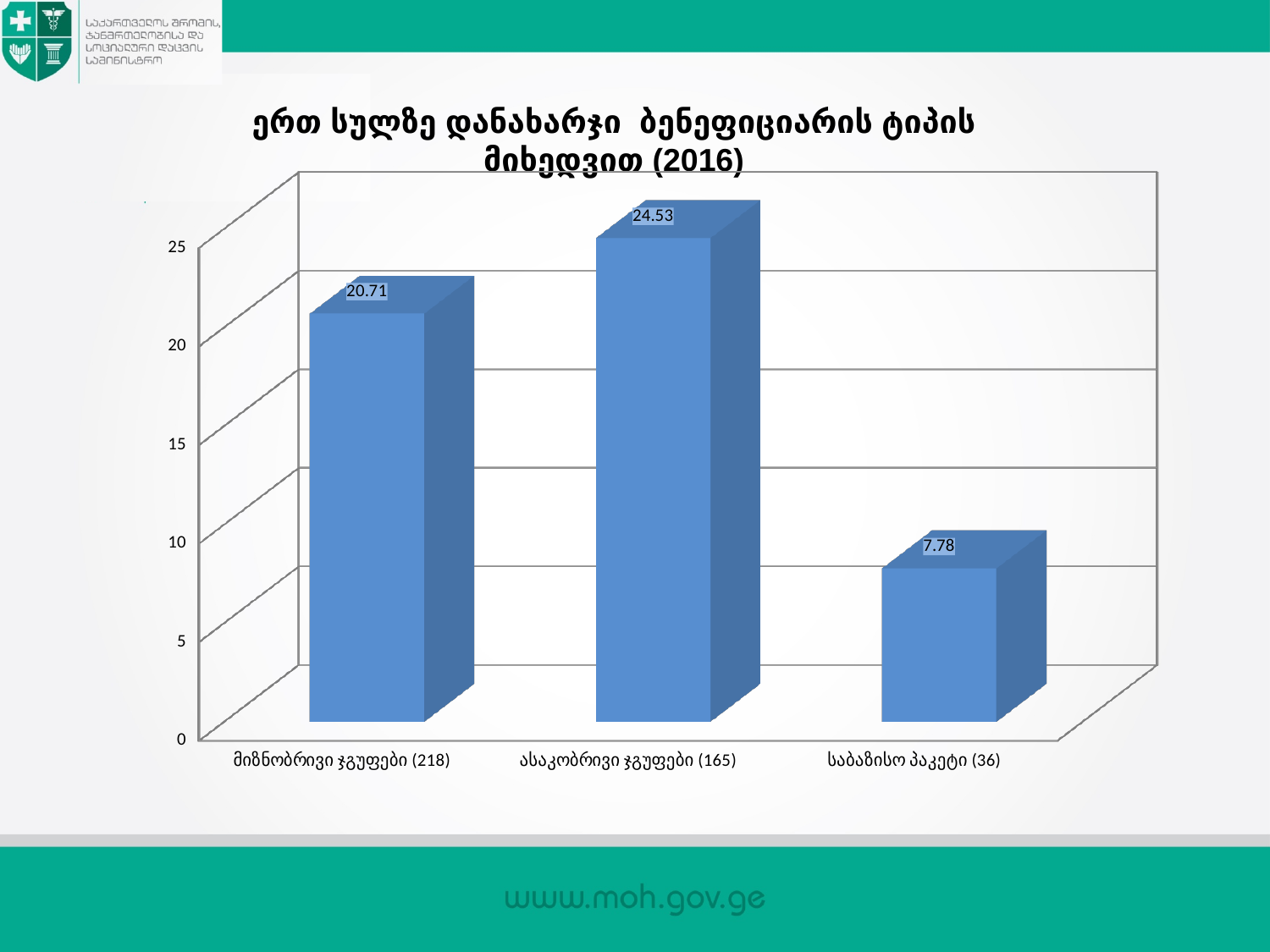
Is the value for საბაზისო პაკეტი (36) greater or less than 10? less Which category has the lowest value? საბაზისო პაკეტი (36) What is the value for ასაკობრივი ჯგუფები (165)? 24.53 How many categories are shown in the chart? 3 What is the value for მიზნობრივი ჯგუფები (218)? 20.71 What is the title of the chart? ერთ სულზე დანახარჯი ბენეფიციარის ტიპის მიხედვით (2016) Which category has the highest value? ასაკობრივი ჯგუფები (165) What is the difference between the values for მიზნობრივი ჯგუფები (218) and საბაზისო პაკეტი (36)? 12.93 What is the value for საბაზისო პაკეტი (36)? 7.78 What kind of chart is shown on the slide? bar chart What is the difference between the values for ასაკობრივი ჯგუფები (165) and მიზნობრივი ჯგუფები (218)? 3.82 Which is larger, the value for მიზნობრივი ჯგუფები (218) or the value for საბაზისო პაკეტი (36)? მიზნობრივი ჯგუფები (218)